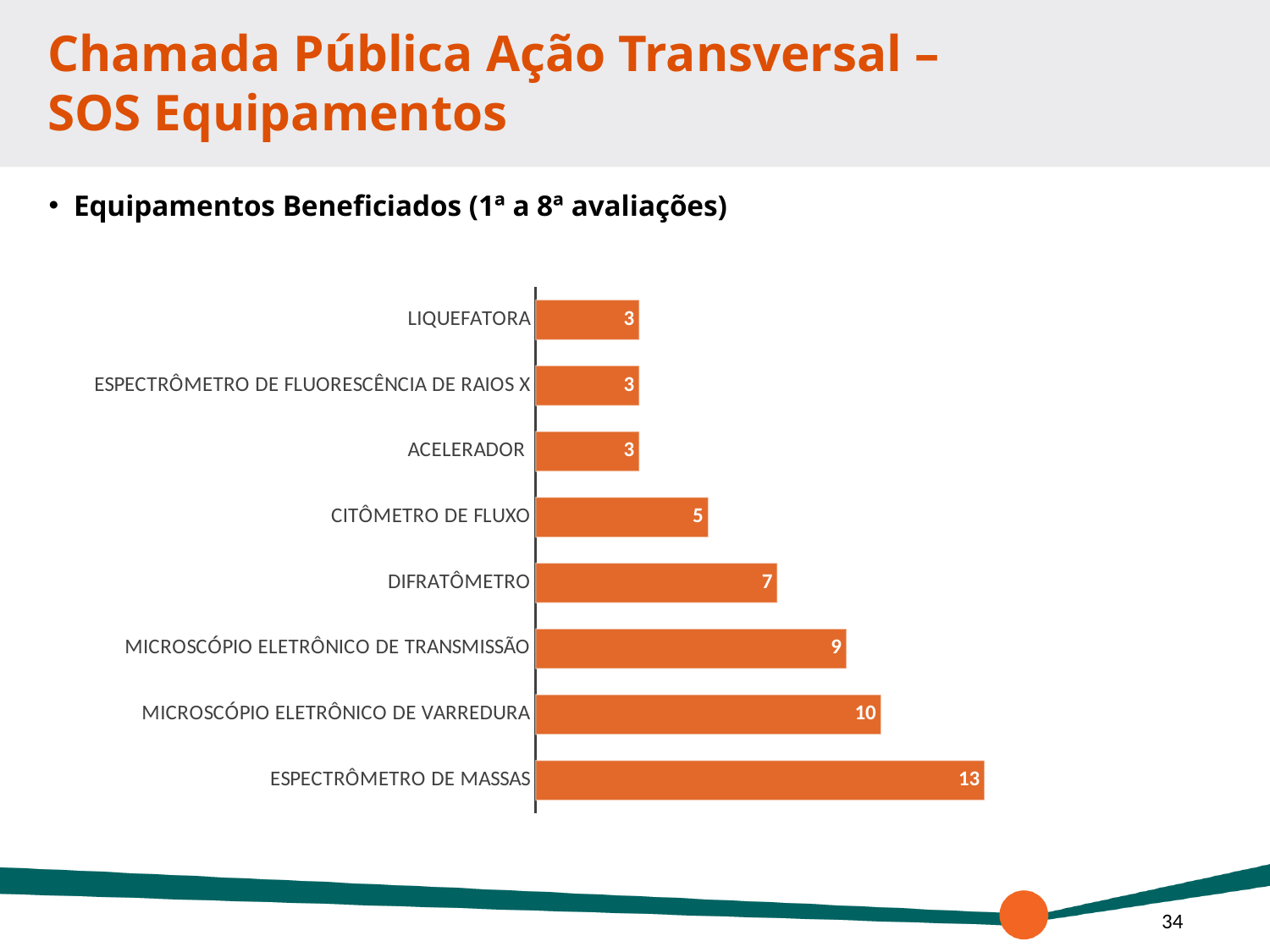
What is the difference between the values for MICROSCÓPIO ELETRÔNICO DE TRANSMISSÃO and CITÔMETRO DE FLUXO? 4 What is the value for CITÔMETRO DE FLUXO? 5 What is the value for ESPECTRÔMETRO DE MASSAS? 13 What kind of chart is shown on the slide? Bar chart Which is larger, the value for DIFRATÔMETRO or the value for ACELERADOR? DIFRATÔMETRO What colour are the bars in the chart? Orange What is the value for DIFRATÔMETRO? 7 How many categories are shown in the chart? 8 Which category has the highest value? ESPECTRÔMETRO DE MASSAS What is the value for MICROSCÓPIO ELETRÔNICO DE VARREDURA? 10 What is the difference between the values for ESPECTRÔMETRO DE MASSAS and MICROSCÓPIO ELETRÔNICO DE VARREDURA? 3 How many categories have a value of 3? 3